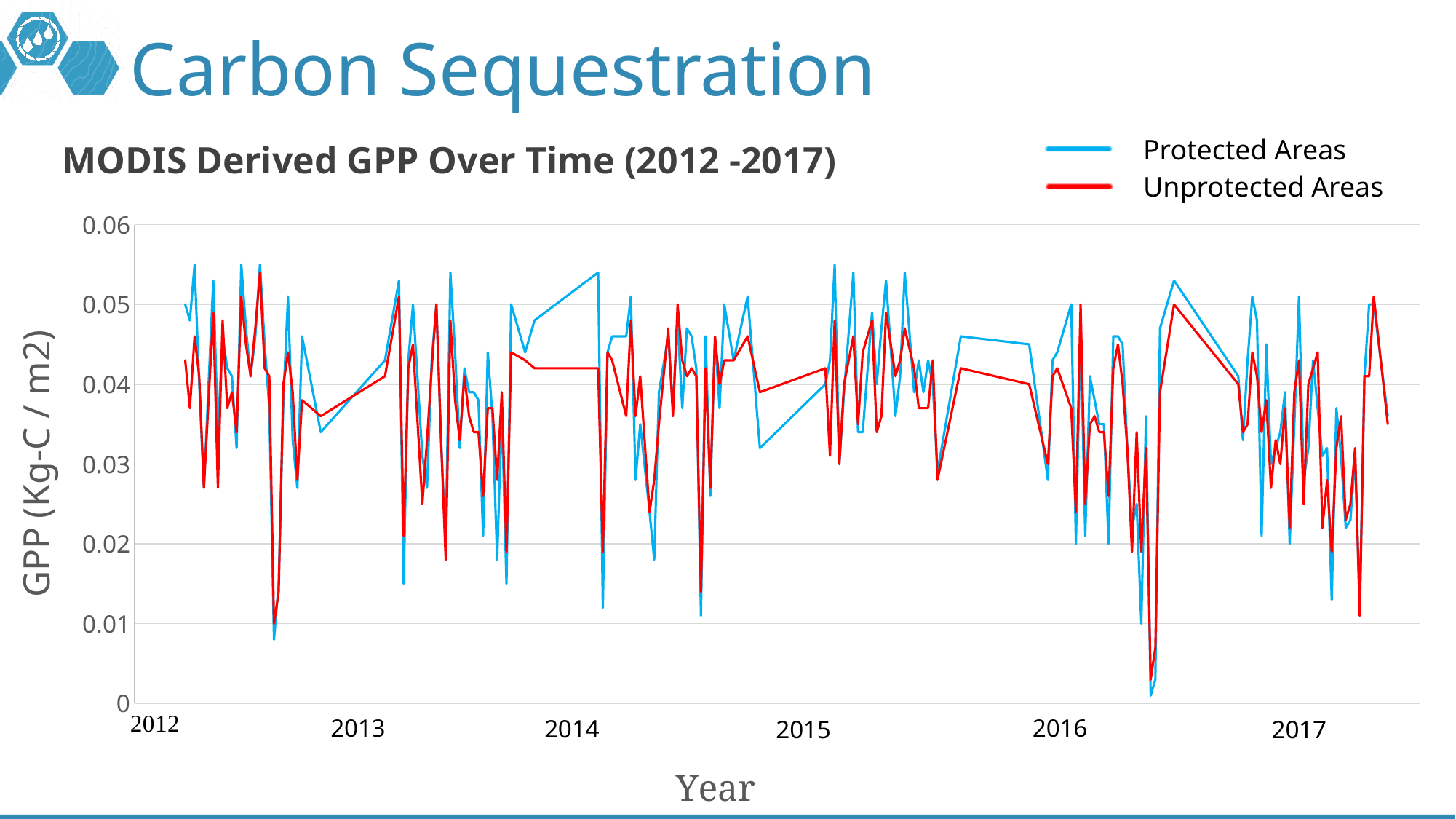
How many series does the legend list? 2 Is the lowest value reached by the Protected Areas series greater or less than 0.01? less What is the label on the y axis of the chart? GPP (Kg-C / m2) What is the highest value marked on the y axis? 0.06 Is the highest value reached by the Protected Areas series greater or less than 0.05? greater How many year labels are shown along the x axis? 6 What kind of chart is shown on the slide? line chart What is the lowest value marked on the y axis? 0 Is the highest value reached by the Unprotected Areas series greater or less than 0.06? less What are the two series named in the legend? Protected Areas and Unprotected Areas